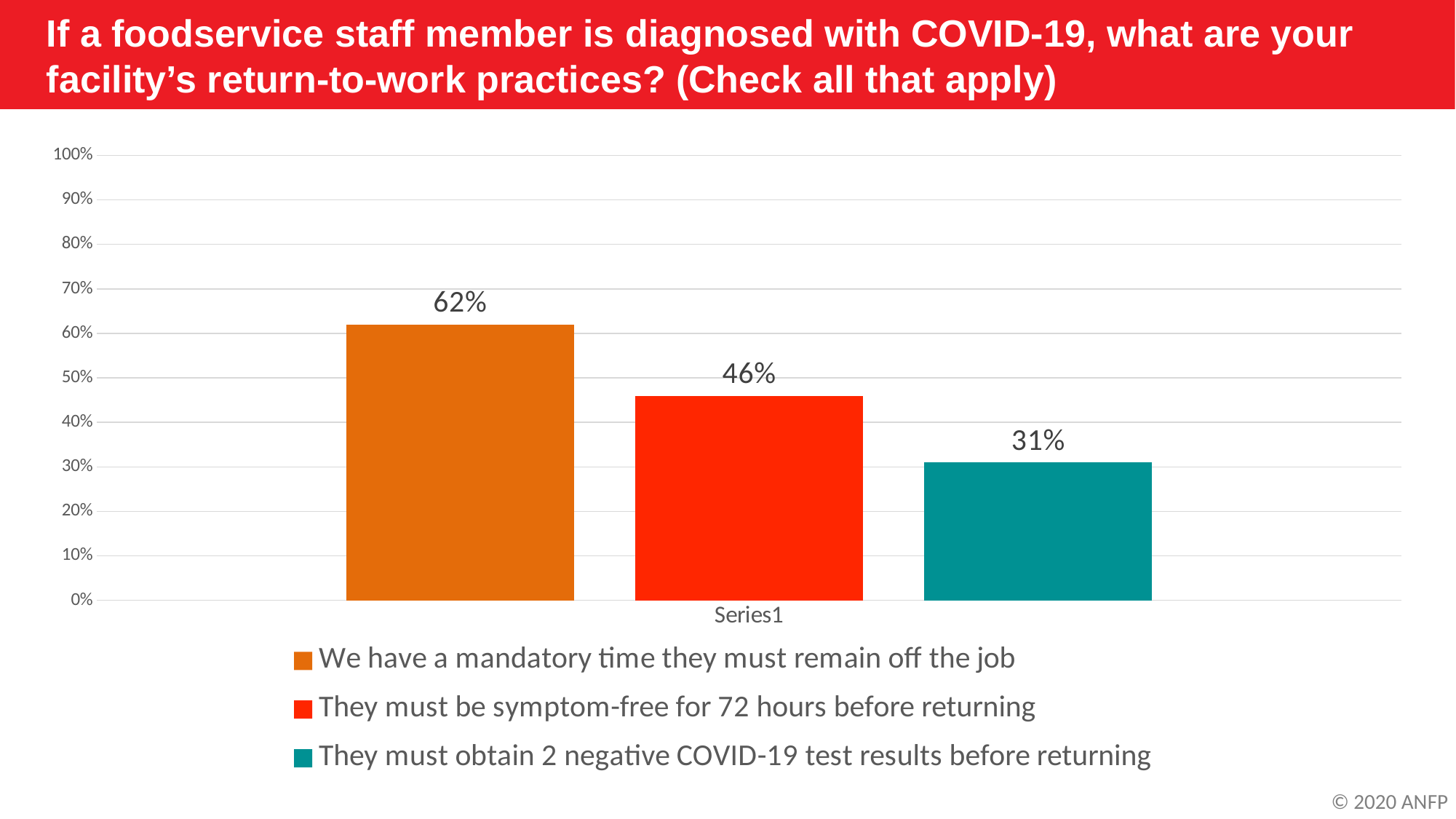
Is the value for the mandatory time off the job practice greater or less than 50%? greater What percentage of respondents said staff must obtain 2 negative COVID-19 test results before returning? 31% What colour is the bar for the practice requiring 2 negative COVID-19 test results? Teal What percentage of respondents said they have a mandatory time staff must remain off the job? 62% What percentage of respondents said staff must be symptom-free for 72 hours before returning? 46% What is the difference in percentage points between the symptom-free for 72 hours practice and the 2 negative test results practice? 15% Which return-to-work practice has the lowest percentage? They must obtain 2 negative COVID-19 test results before returning Which return-to-work practice has the highest percentage? We have a mandatory time they must remain off the job How many return-to-work practices are plotted on the chart? 3 What kind of chart is shown on the slide? Bar chart Which is larger: the percentage for symptom-free for 72 hours or the percentage for 2 negative COVID-19 test results? They must be symptom-free for 72 hours before returning What is the difference in percentage points between the mandatory time off the job practice and the symptom-free for 72 hours practice? 16%